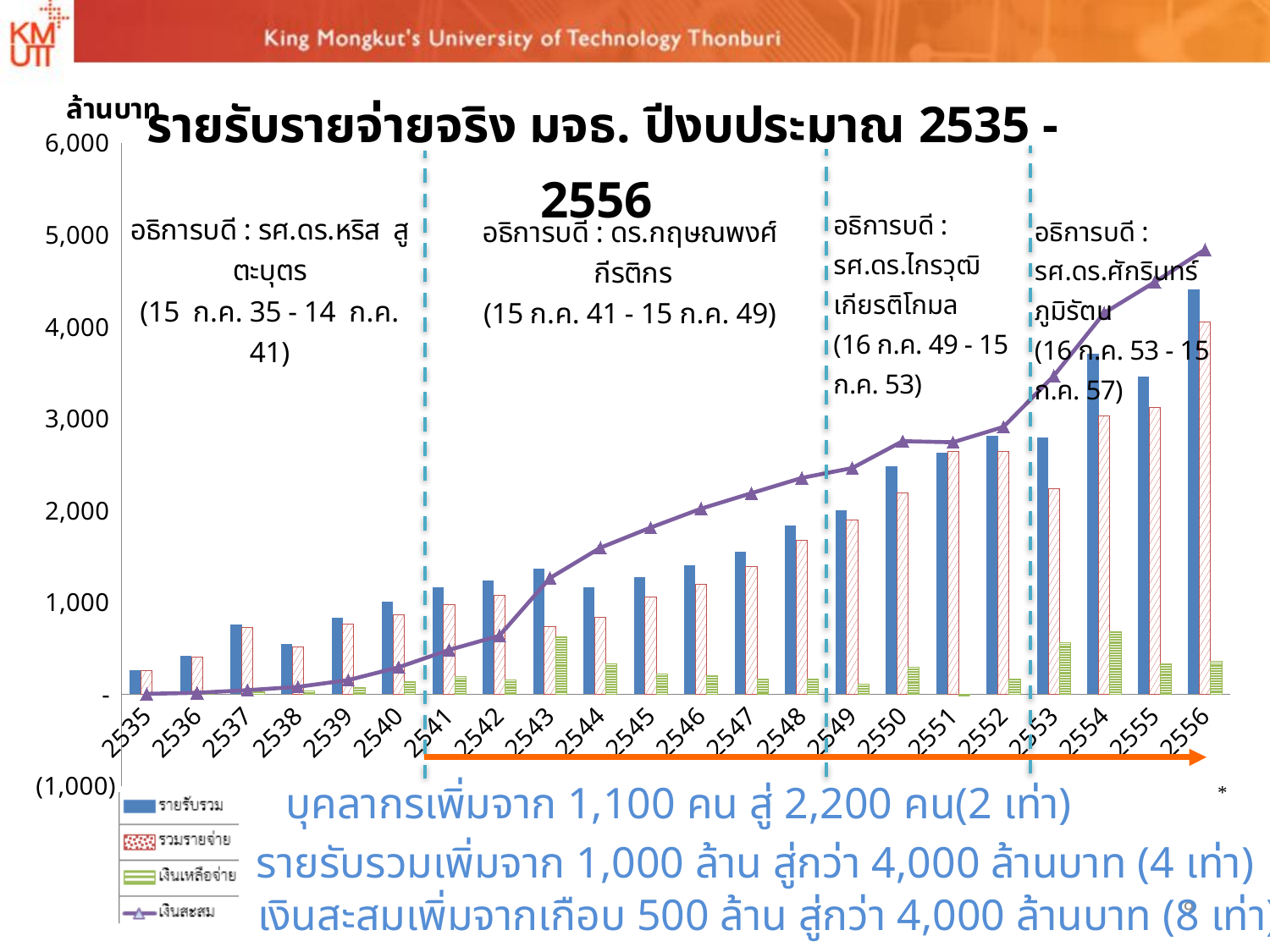
Is the รายรับรวม value for 2550 greater or less than 2,000? greater In 2556, which is larger: เงินสะสม or รายรับรวม? เงินสะสม How many series does the chart legend list? 4 How many fiscal years are shown along the x axis of the chart? 22 What kind of chart is shown on the slide? A combined bar and line chart Is the รายรับรวม value for 2556 greater or less than 4,000? greater Does the เงินสะสม line generally rise or fall from 2535 to 2556? rise Which year has the lowest รายรับรวม (blue bar)? 2535 Which is larger: รายรับรวม in 2556 or รายรับรวม in 2555? 2556 Which year has the highest รายรับรวม (blue bar)? 2556 What unit is shown at the top of the y axis of the chart? ล้านบาท Is the เงินสะสม value for 2541 greater or less than 1,000? less